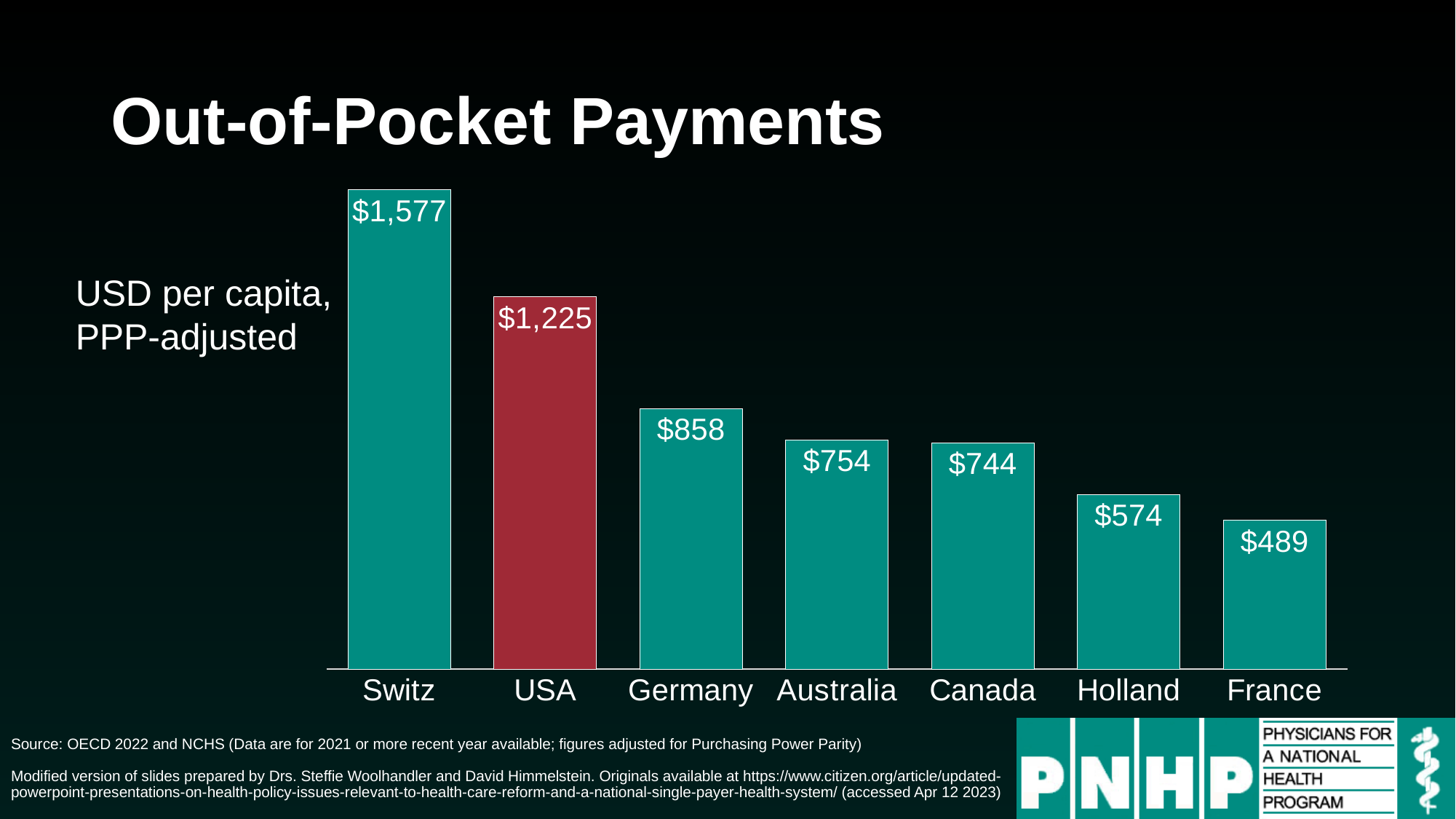
What is the out-of-pocket payment value for Germany? $858 Do the values rise or fall from left to right across the chart? Fall What is the out-of-pocket payment value for Holland? $574 Which has a larger value, Germany or Holland? Germany What is the out-of-pocket payment value for the USA? $1,225 What is the difference between the values for Australia and Canada? $10 Which country has the lowest out-of-pocket payments? France Which country has the highest out-of-pocket payments? Switz What kind of chart is shown on the slide? Bar chart What is the difference between the values for Switz and the USA? $352 Which country's bar is coloured differently (red) from the others? USA How many countries are shown in the chart? 7